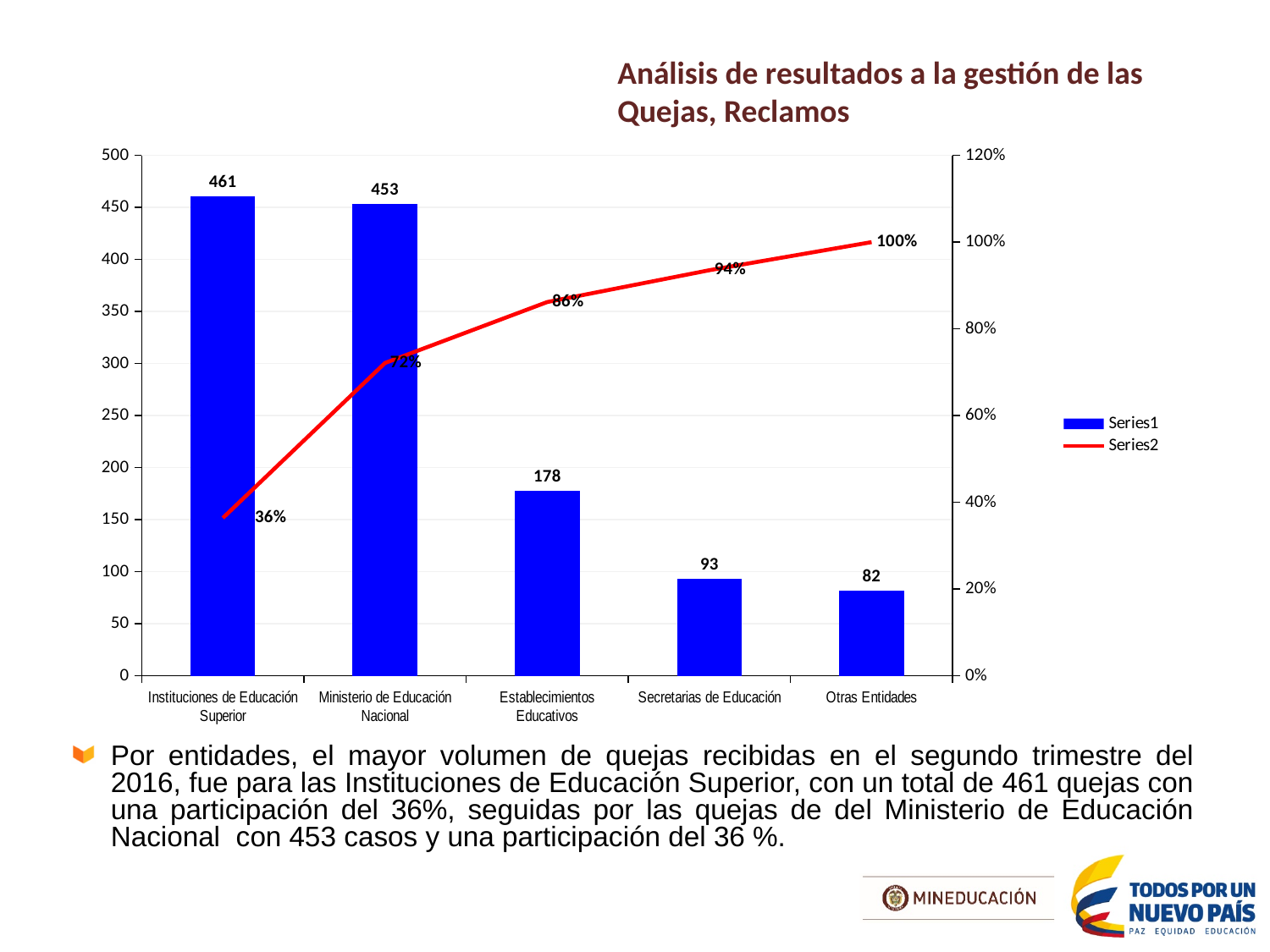
How many categories are shown on the x axis? 5 Which category has the lowest Series1 value? Otras Entidades What is the Series1 value for Establecimientos Educativos? 178 What is the difference between the Series1 values for Instituciones de Educación Superior and Ministerio de Educación Nacional? 8 Does the Series2 line rise or fall from left to right across the categories? rise What is the Series2 value for Otras Entidades? 100% Which category has the highest Series1 value? Instituciones de Educación Superior How many series does the legend list? 2 What colour are the Series1 bars? Blue What is the Series1 value for Instituciones de Educación Superior? 461 What is the Series2 value for Ministerio de Educación Nacional? 72% Which has a larger Series1 value, Secretarias de Educación or Establecimientos Educativos? Establecimientos Educativos